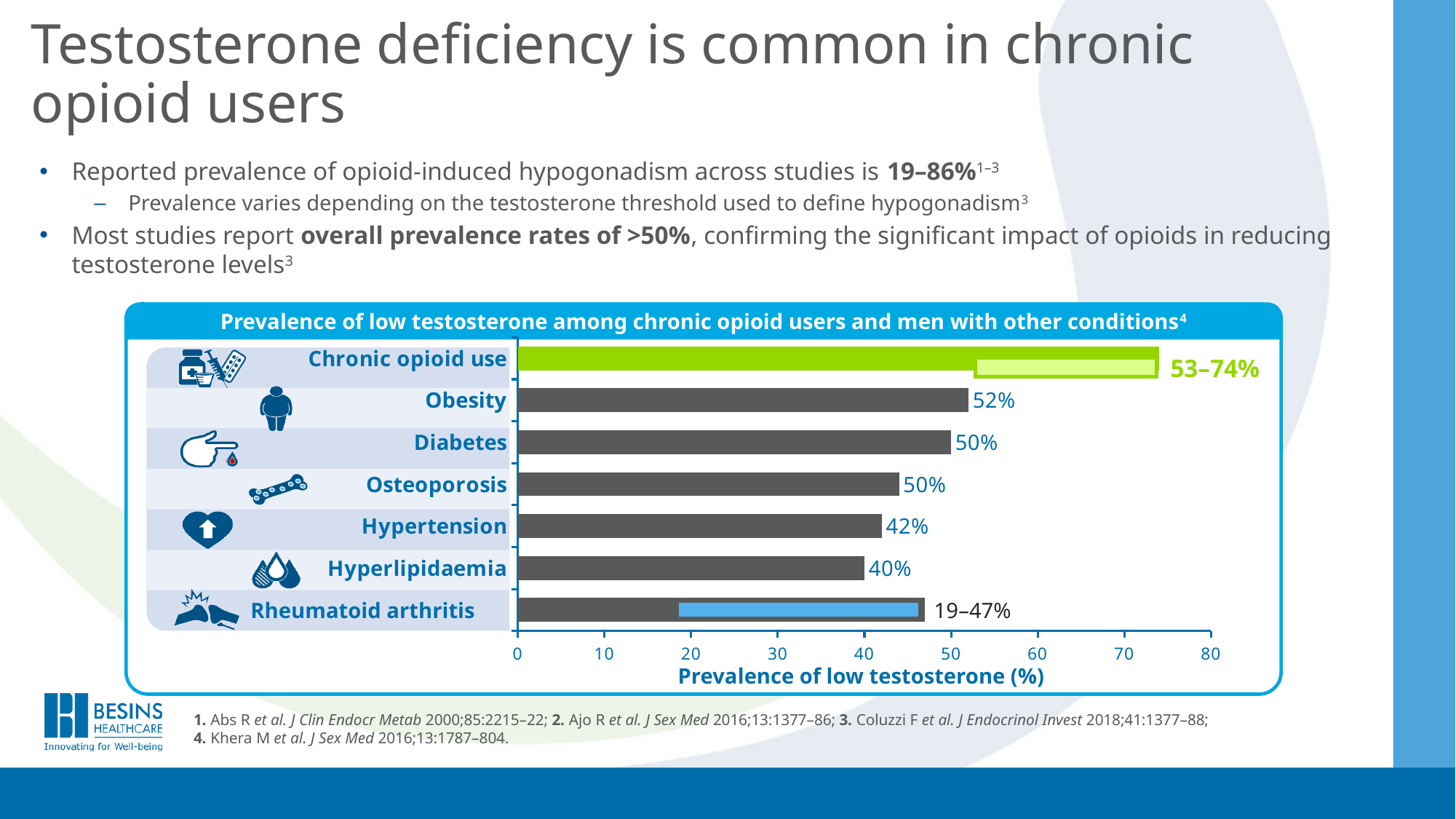
Is the value for Hyperlipidaemia greater or less than 50? less What is the prevalence of low testosterone shown for Obesity? 52% What value is shown for Hypertension? 42% What is the label of the x axis of the chart? Prevalence of low testosterone (%) What range is shown for Chronic opioid use? 53–74% What value is shown for Hyperlipidaemia? 40% How many conditions are listed in the chart? 7 What kind of chart is shown on the slide? Bar chart What range is shown for Rheumatoid arthritis? 19–47% Which condition has the longest bar in the chart? Chronic opioid use Which has a higher value, Obesity or Hypertension? Obesity What is the difference between the values for Obesity and Hyperlipidaemia? 12%